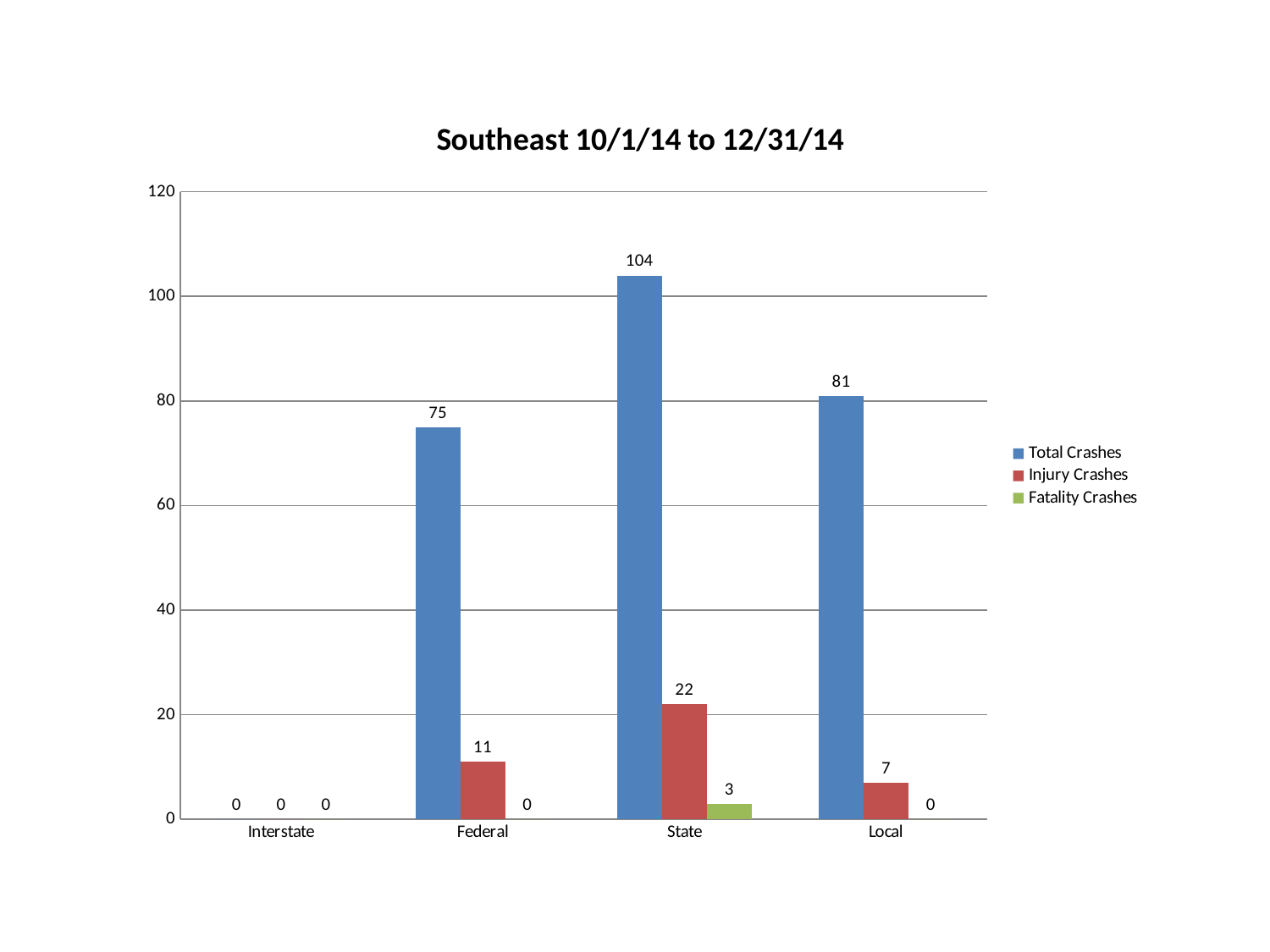
What is the title of the chart? Southeast 10/1/14 to 12/31/14 What is the value of Injury Crashes for Federal? 11 Is the value of Total Crashes for Federal greater or less than 80? less What kind of chart is shown on the slide? bar chart What is the value of Fatality Crashes for State? 3 What is the difference between Total Crashes for State and Total Crashes for Local? 23 How many series does the legend list? 3 What is the value of Total Crashes for State? 104 Which category has the lowest Injury Crashes? Interstate How many categories are shown on the x axis? 4 Which category has the highest Total Crashes? State Which is larger: Injury Crashes for State or Injury Crashes for Local? State